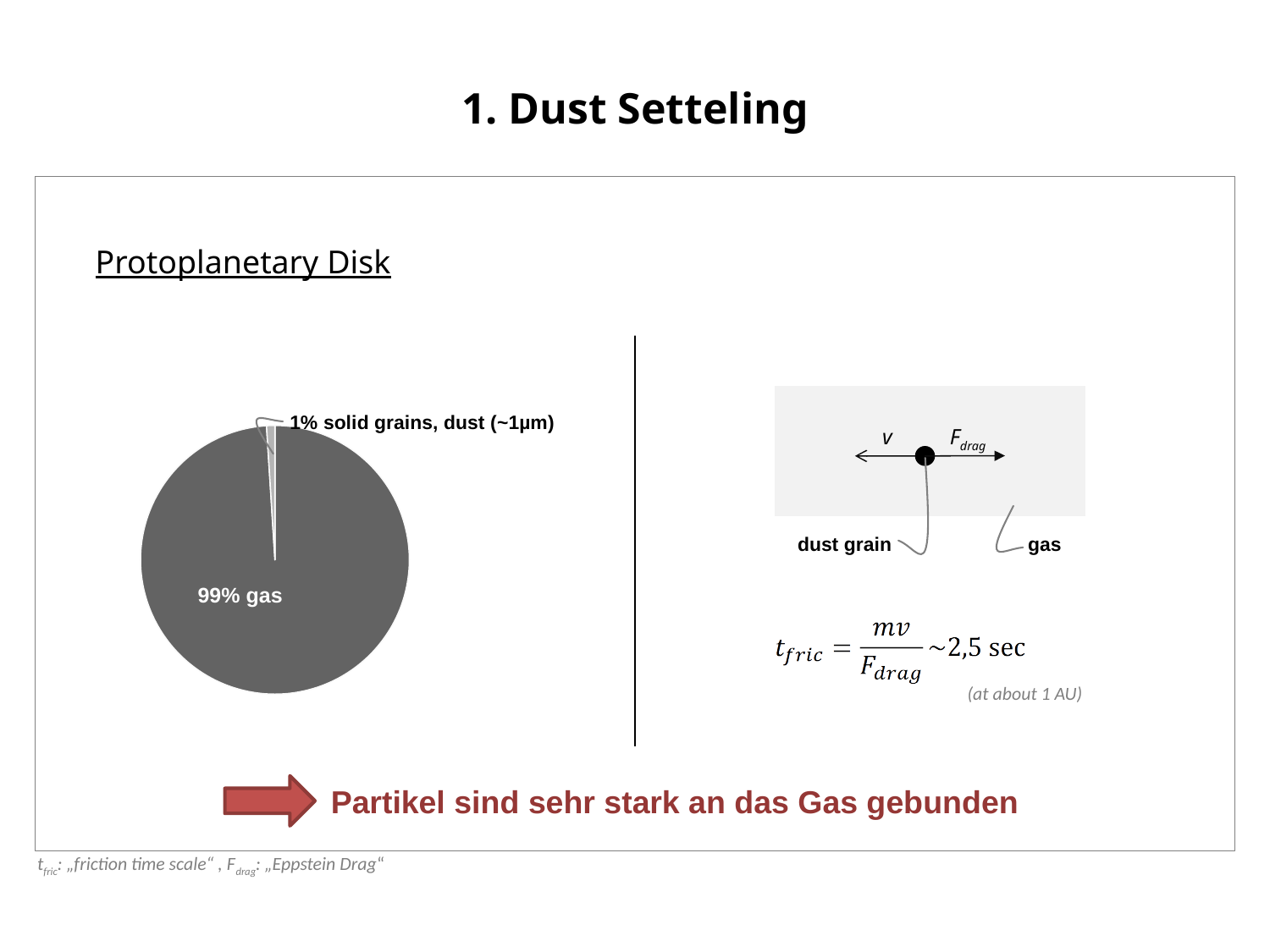
What kind of chart is shown on the slide under the heading "Protoplanetary Disk"? pie chart What is the underlined heading above the pie chart? Protoplanetary Disk By how many percentage points does the gas share exceed the solid grains share in the pie chart? 98 What is the value printed on the gas slice of the pie chart? 99% gas What share of the pie chart do solid grains (dust) make up? 1% What colour is the gas slice of the pie chart? dark grey Which is larger in the pie chart, the gas slice or the solid grains slice? gas Which slice of the pie chart is the largest? gas How many slices does the pie chart have? 2 What share of the pie chart does gas make up? 99% What typical grain size is given in the label of the solid grains slice? ~1μm Which slice of the pie chart is the smallest? solid grains, dust